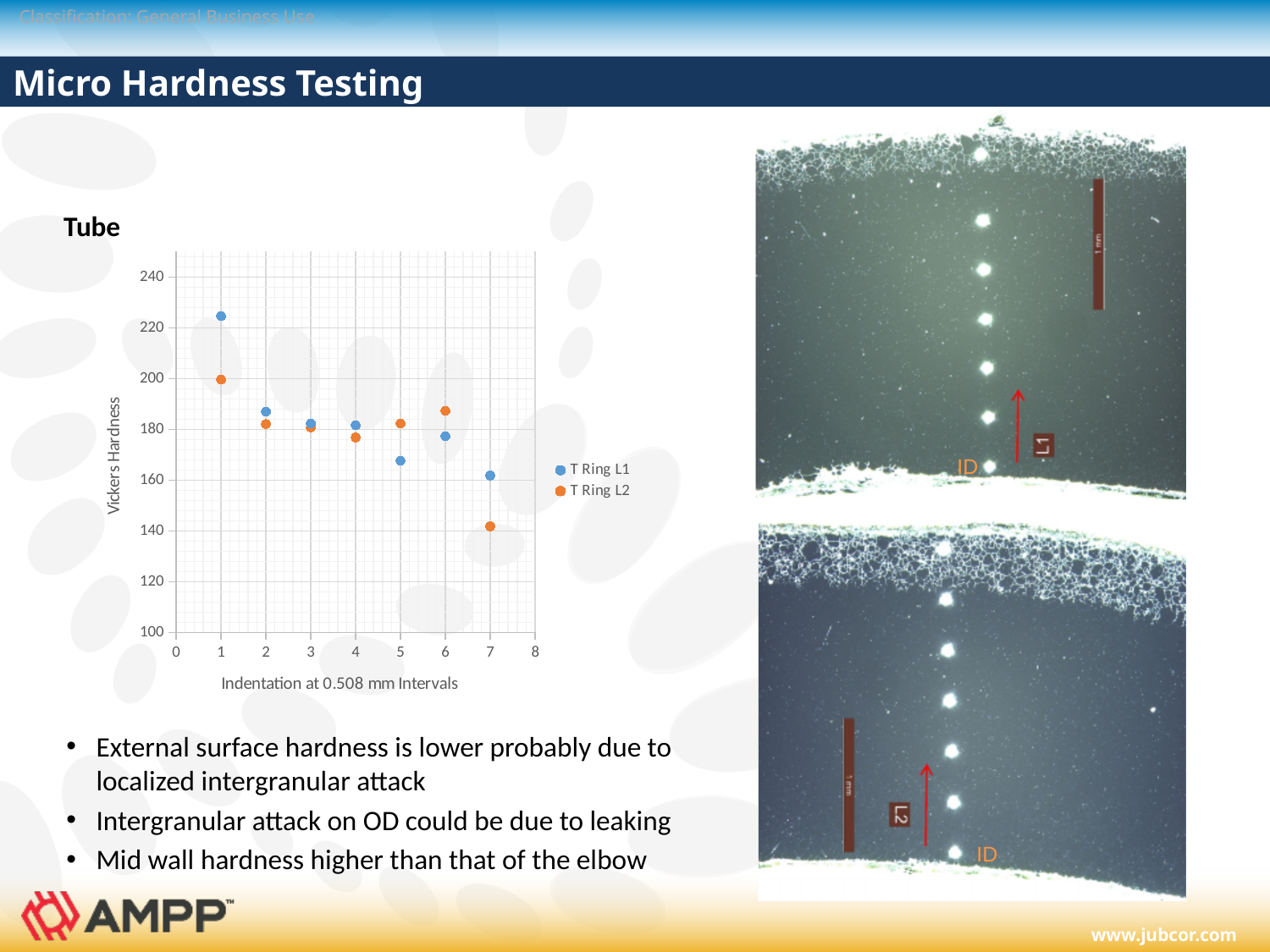
How many data points are plotted for the T Ring L1 series? 7 What are the two series named in the chart legend? T Ring L1 and T Ring L2 What kind of chart is shown on the slide? Scatter chart At which indentation number is the T Ring L2 hardness lowest? 7 Does the T Ring L1 hardness generally rise or fall as the indentation number increases from 1 to 7? Fall Is the T Ring L2 value at indentation 7 greater or less than 160? less Is the T Ring L1 value at indentation 7 greater or less than 180? less At indentation 1, which series has the higher Vickers hardness, T Ring L1 or T Ring L2? T Ring L1 How many series does the chart legend list? 2 At which indentation number is the T Ring L1 hardness highest? 1 What is the title of the chart's y axis? Vickers Hardness Is the T Ring L1 value at indentation 1 greater or less than 200? greater